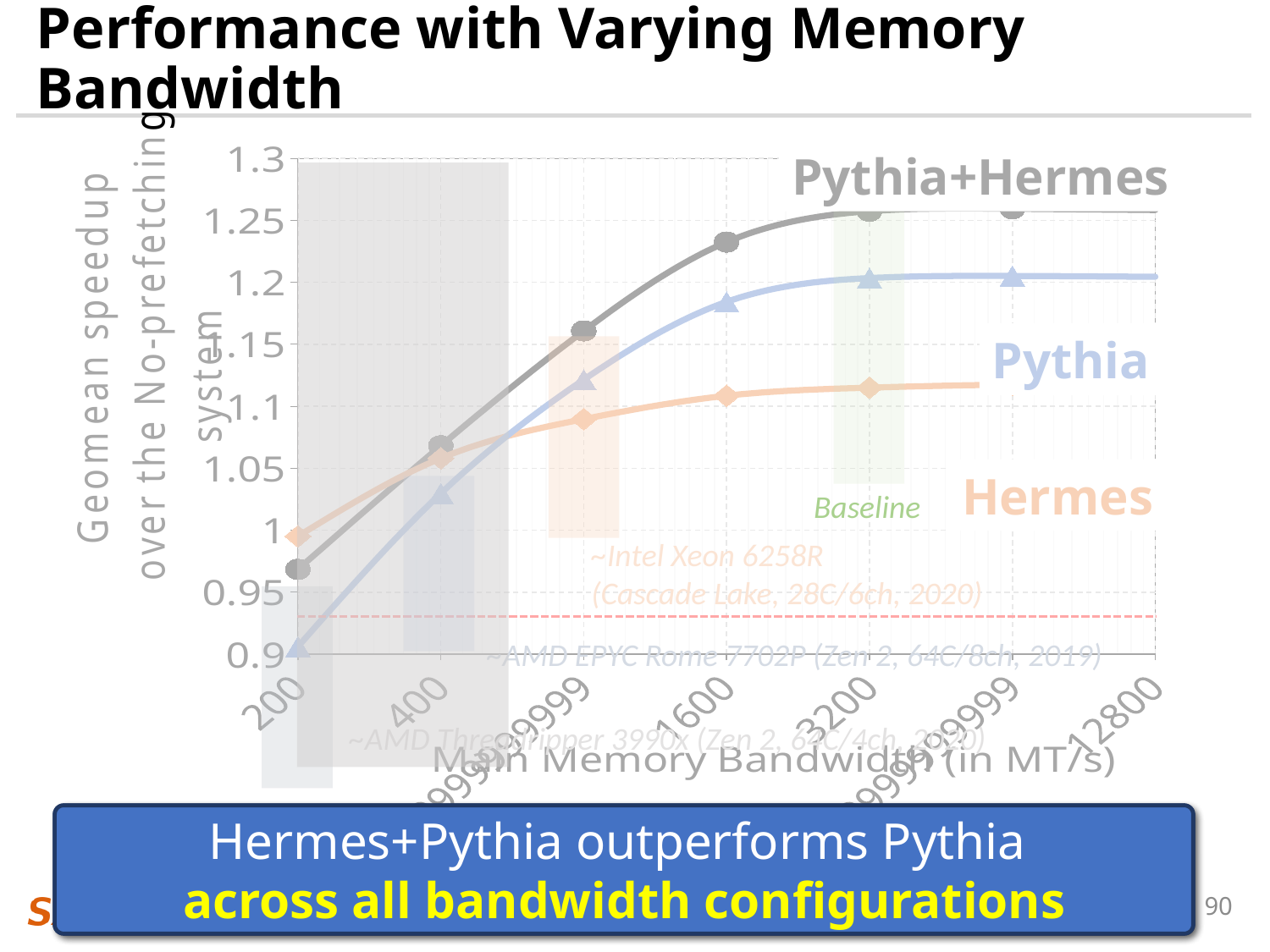
What kind of chart is shown on the slide? line chart Does the Pythia+Hermes series rise or fall as memory bandwidth increases along the x axis? rises Is the value for Pythia+Hermes at 1600 MT/s greater or less than 1.2? greater How many series are plotted in the chart? 3 Is the value for Pythia+Hermes at 400 MT/s greater or less than 1? greater Is the value for Pythia at 200 MT/s greater or less than 0.95? less At 1600 MT/s, which is larger: the value for Pythia or the value for Hermes? Pythia Which series has the highest speedup at 3200 MT/s? Pythia+Hermes Which series has the highest speedup at 200 MT/s? Hermes What is the title of the x axis? Main Memory Bandwidth (in MT/s) Which series has the lowest speedup at 200 MT/s? Pythia